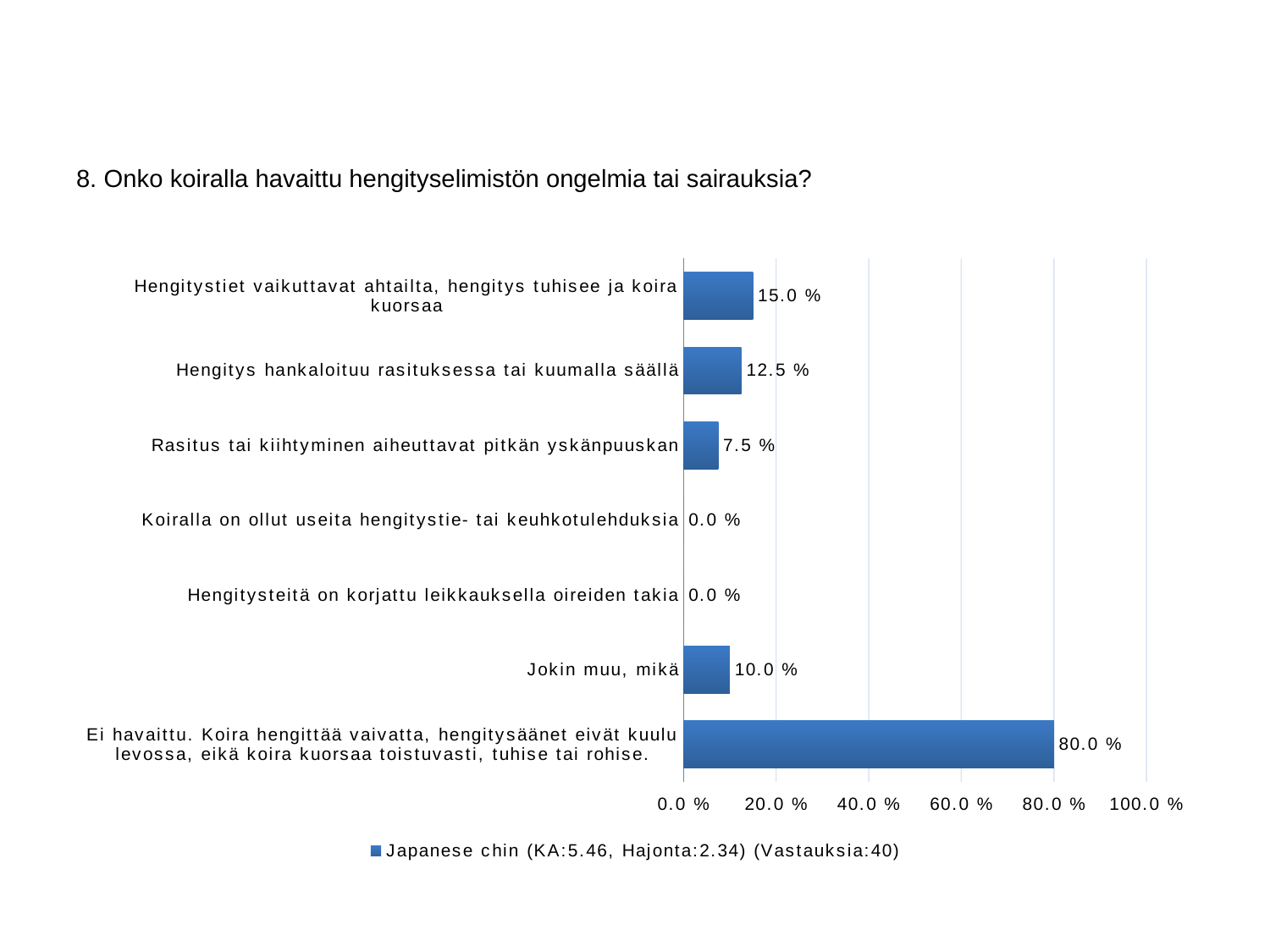
What is the value for "Rasitus tai kiihtyminen aiheuttavat pitkän yskänpuuskan"? 7.5 % Which category has the highest value? Ei havaittu. Koira hengittää vaivatta, hengitysäänet eivät kuulu levossa, eikä koira kuorsaa toistuvasti, tuhise tai rohise. Which is larger: the value for "Hengitystiet vaikuttavat ahtailta, hengitys tuhisee ja koira kuorsaa" or the value for "Jokin muu, mikä"? Hengitystiet vaikuttavat ahtailta, hengitys tuhisee ja koira kuorsaa How many series does the legend list? 1 What is the value for "Hengitys hankaloituu rasituksessa tai kuumalla säällä"? 12.5 % How many categories are shown in the chart? 7 Is the value for "Ei havaittu..." greater or less than 60.0 %? greater How many categories have a value of 0.0 %? 2 How many responses (Vastauksia) does the legend indicate? 40 What is the value for "Jokin muu, mikä"? 10.0 % What kind of chart is shown on the slide? Bar chart What is the difference between the value for "Ei havaittu..." (80.0 %) and the value for "Hengitystiet vaikuttavat ahtailta, hengitys tuhisee ja koira kuorsaa"? 65.0 %